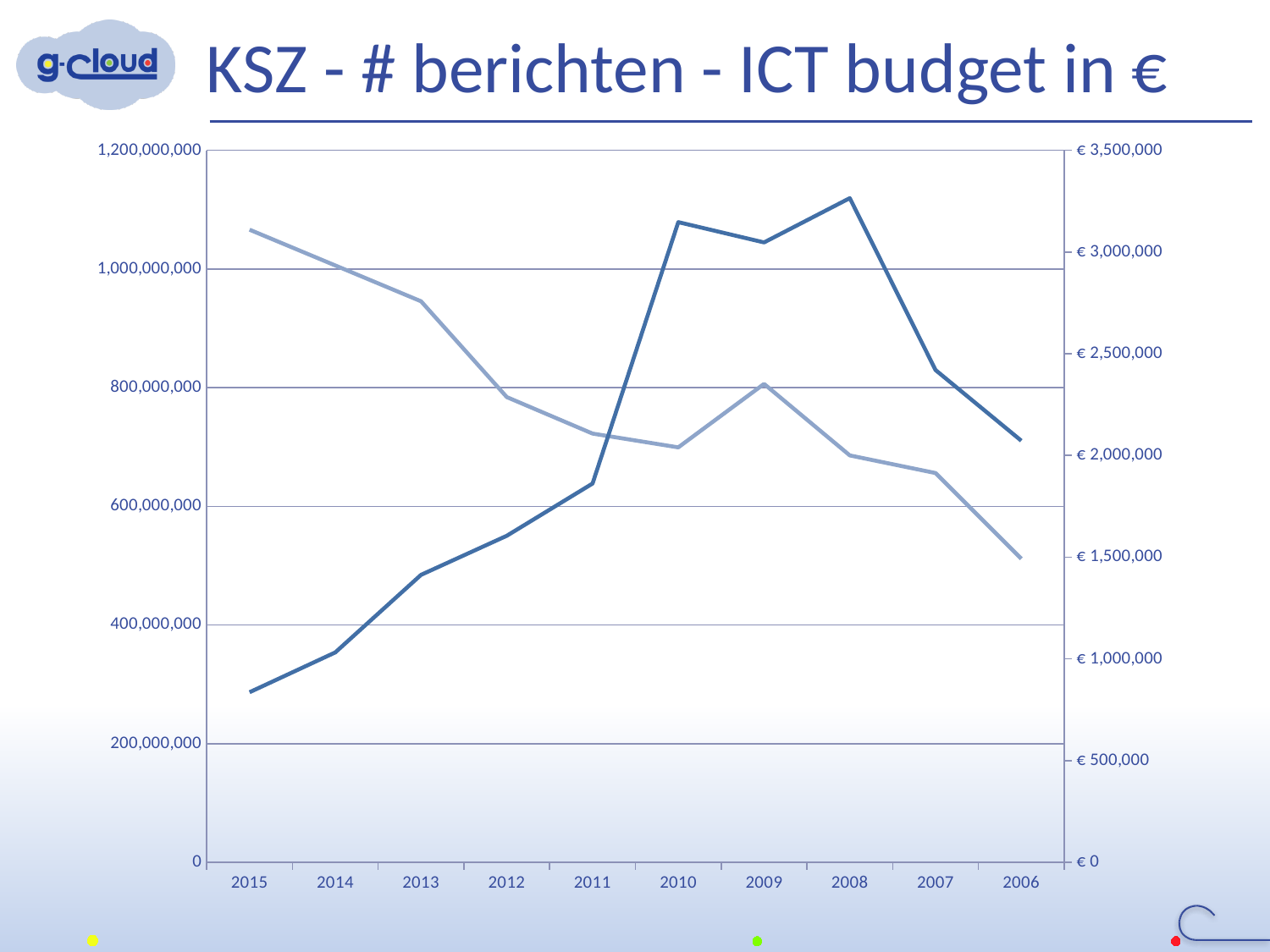
In which year is the darker blue line at its lowest point? 2015 In which year is the lighter blue line at its highest point? 2015 How many years are shown along the x axis of the chart? 10 In which year is the lighter blue line at its lowest point? 2006 What kind of chart is shown on the slide? line chart Moving from 2015 on the left to 2006 on the right, does the lighter blue line overall rise or fall? fall In which year does the darker blue line reach its highest point? 2008 Moving from 2015 to 2010 along the x axis, does the darker blue line rise or fall? rise What is the title of the chart slide? KSZ - # berichten - ICT budget in € Read against the left-hand axis, is the lighter blue line's value for 2015 greater or less than 1,000,000,000? greater How many lines are plotted on the chart? 2 What is the highest tick value shown on the right-hand axis of the chart? € 3,500,000